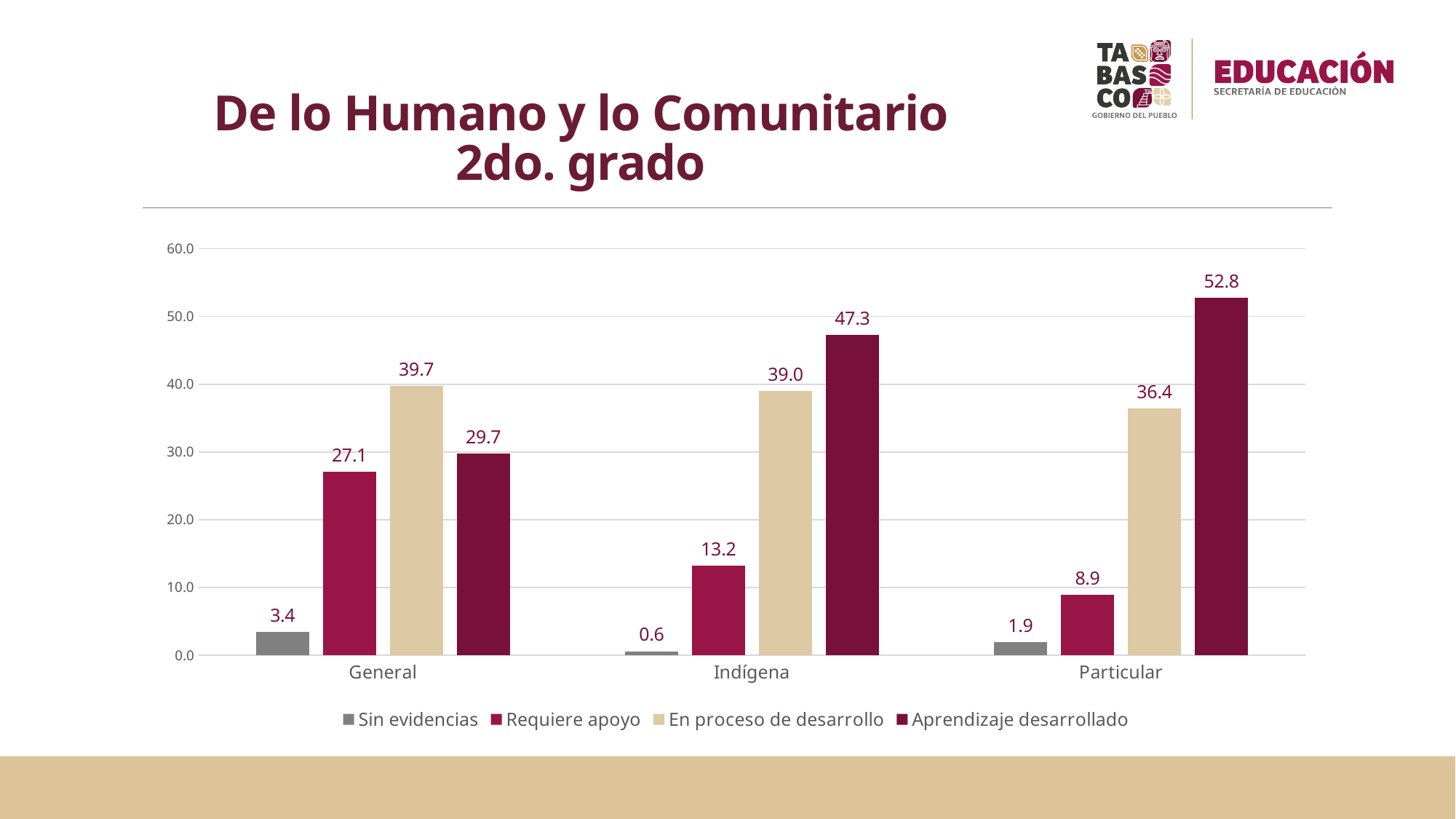
Which category has the highest value for Aprendizaje desarrollado? Particular What is the title of the slide? De lo Humano y lo Comunitario 2do. grado What is the difference between Aprendizaje desarrollado and En proceso de desarrollo in the Indígena category? 8.3 What is the value for Sin evidencias in the Indígena category? 0.6 What is the value for Aprendizaje desarrollado in the Particular category? 52.8 What is the value for En proceso de desarrollo in the Indígena category? 39.0 How many categories are shown on the x axis? 3 How many series does the legend list? 4 Which is larger in the General category: En proceso de desarrollo or Aprendizaje desarrollado? En proceso de desarrollo Which category has the lowest value for Requiere apoyo? Particular What kind of chart is shown on the slide? Bar chart What is the value for Requiere apoyo in the General category? 27.1